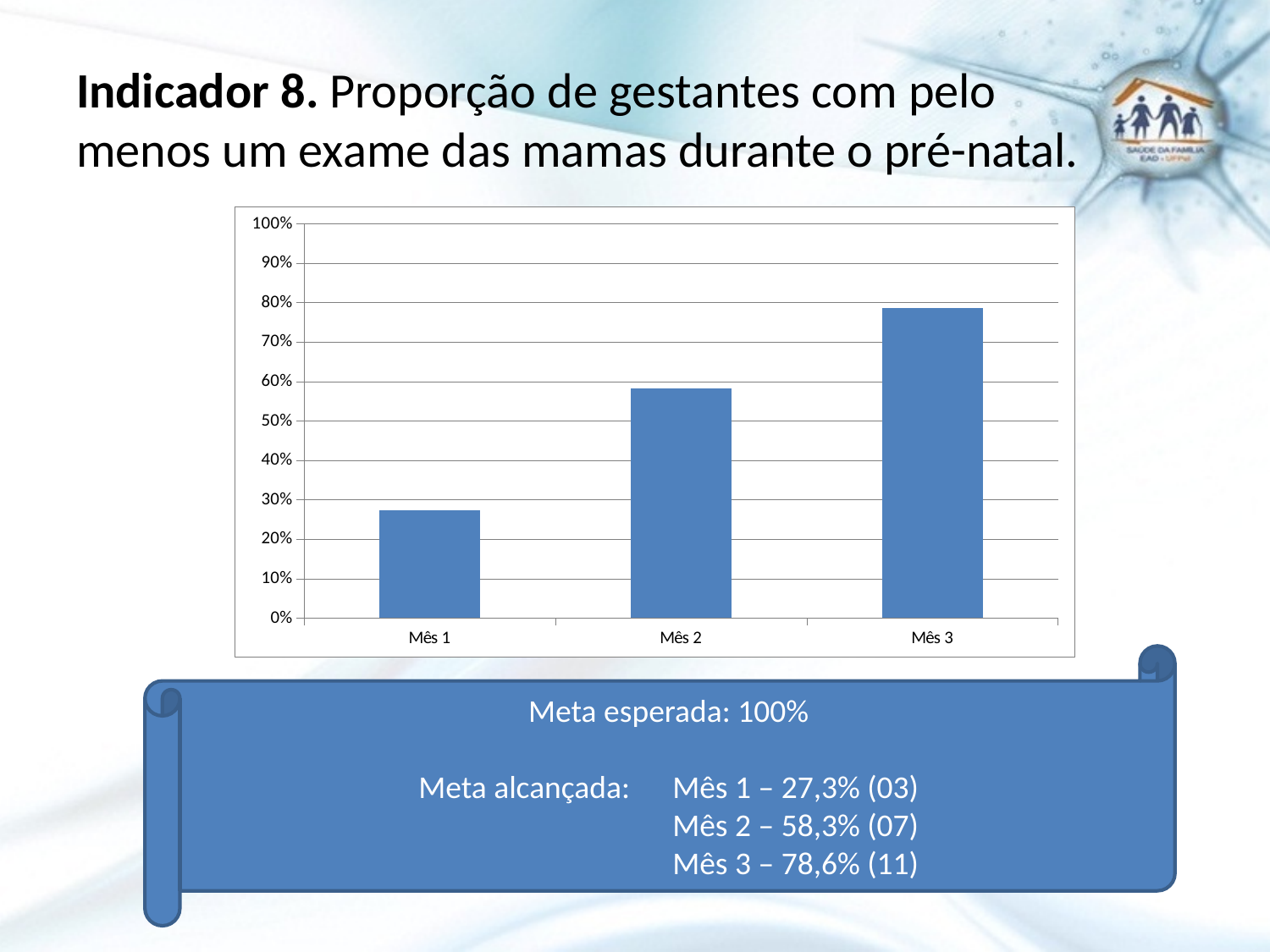
Is the value for Mês 3 greater or less than 80%? less Which month has the highest bar on the chart? Mês 3 Do the values rise or fall from Mês 1 to Mês 3? rise How many categories (months) are plotted on the chart? 3 What is the maximum value shown on the chart's vertical axis? 100% According to the slide, what proportion was reached in Mês 1? 27,3% Is the value for Mês 2 greater or less than 50%? greater Is the value for Mês 1 greater or less than 30%? less What kind of chart is shown on the slide? bar chart According to the slide, what proportion was reached in Mês 3? 78,6% Which month has the lowest bar on the chart? Mês 1 Which is larger, the value for Mês 2 or the value for Mês 3? Mês 3